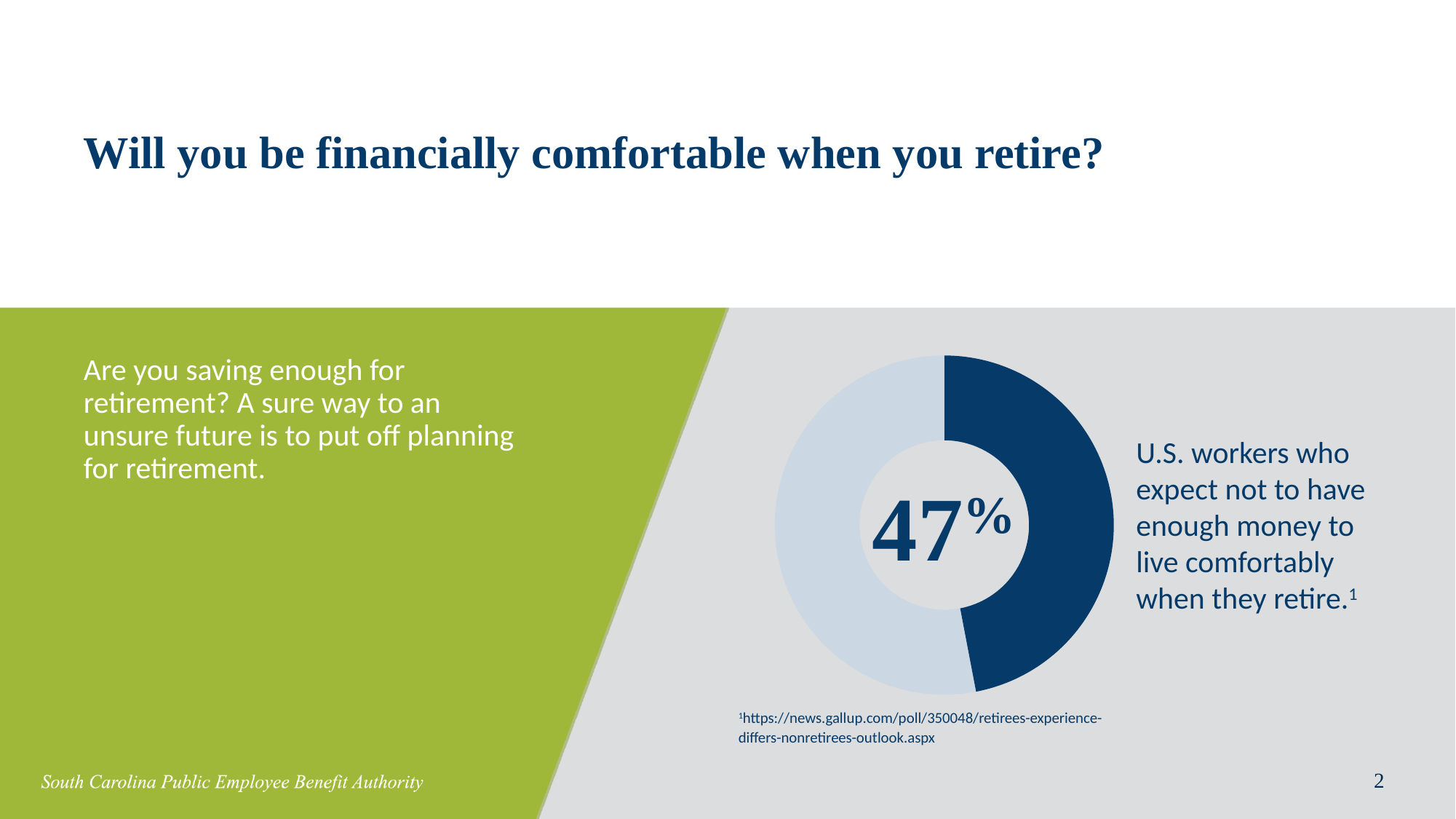
What percentage is printed in the centre of the donut chart? 47% What colour is the segment of the donut chart that corresponds to the 47% value? Dark blue How many segments does the donut chart have? 2 According to the text next to the donut chart, what group does the 47% figure describe? U.S. workers who expect not to have enough money to live comfortably when they retire What share of the donut chart does the dark blue segment represent? 47% What kind of chart is shown on the slide? Donut (pie) chart Is the value shown for the dark blue segment of the donut chart greater or less than 50%? less